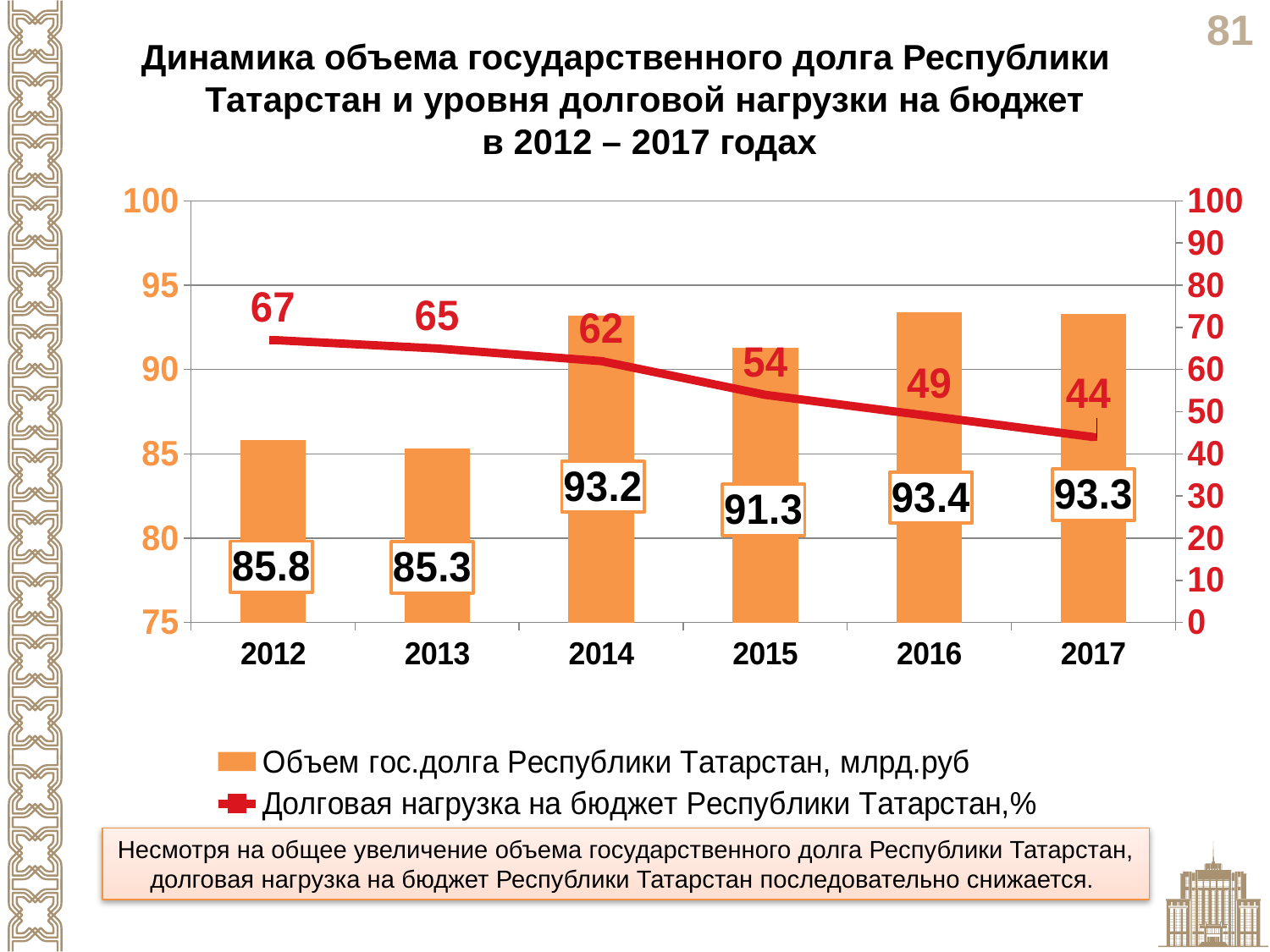
What is the difference between the state debt volume in 2016 and in 2012? 7.6 How many series does the legend list? 2 In which year is the debt burden on the budget the highest? 2012 In which year is the state debt volume the lowest? 2013 What is the debt burden on the budget (Долговая нагрузка) for 2015? 54 Which is larger, the state debt volume in 2014 or in 2015? 2014 What is the difference between the debt burden in 2012 and in 2017? 23 What is the state debt volume for 2012? 85.8 In which year is the debt burden on the budget the lowest? 2017 Does the debt burden on the budget rise or fall from 2012 to 2017? fall How many years are shown on the x axis? 6 What is the value of the state debt volume (Объем гос.долга) for 2014? 93.2